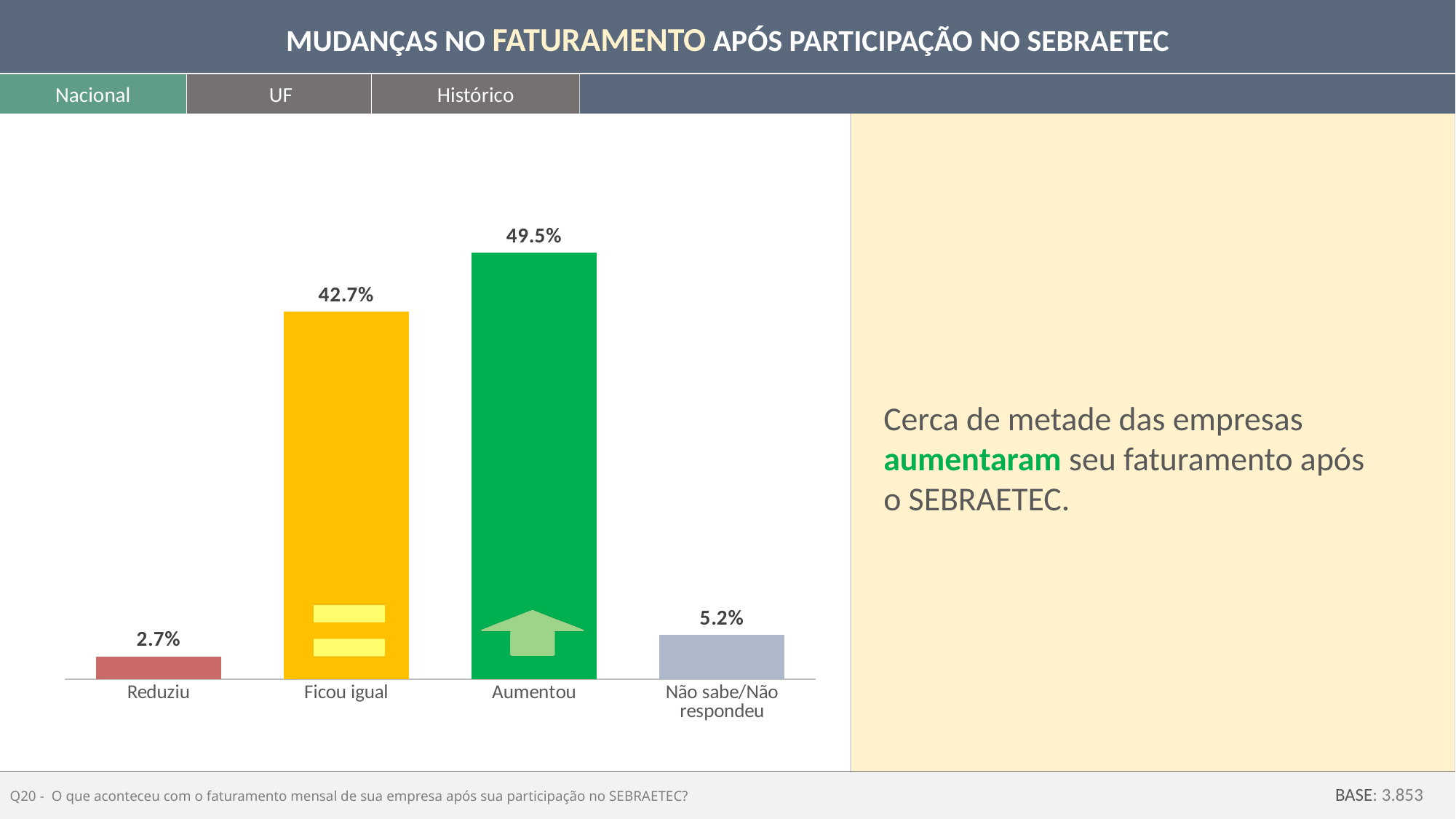
What is the value for Não sabe/Não respondeu? 5.2% What is the value for Reduziu? 2.7% What kind of chart is shown on the slide? Bar chart What is the difference between the values for Não sabe/Não respondeu and Reduziu? 2.5% What is the value for Aumentou? 49.5% How many categories are shown in the chart? 4 Which is larger, the value for Não sabe/Não respondeu or the value for Reduziu? Não sabe/Não respondeu What is the value for Ficou igual? 42.7% Which category has the lowest value? Reduziu What colour is the bar for Aumentou? Green What is the difference between the values for Aumentou and Ficou igual? 6.8% Which category has the highest value? Aumentou